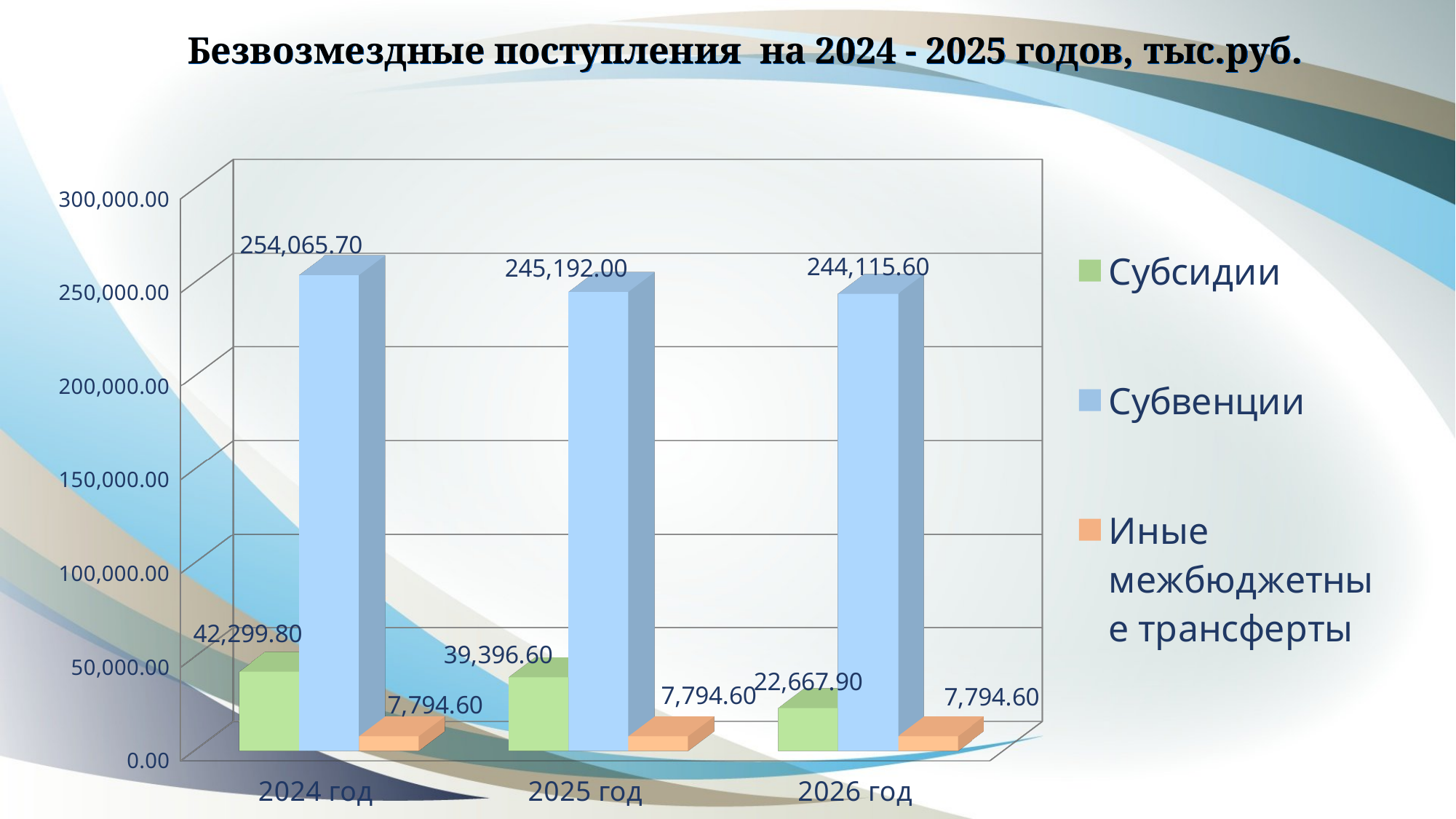
Which is larger: Субвенции in 2025 год or Субвенции in 2026 год? Субвенции in 2025 год Do the values for Субсидии rise or fall from 2024 год to 2026 год? fall How many series does the legend list? 3 What kind of chart is shown on the slide? bar chart Is the value for Субсидии in 2024 год greater or less than 50,000.00? less What is the value for Субвенции in 2024 год? 254,065.70 How many years are shown on the x axis? 3 What is the difference between the Субсидии values for 2024 год and 2025 год? 2,903.20 What is the value for Субсидии in 2026 год? 22,667.90 In which year is the value for Субсидии lowest? 2026 год In which year is the value for Субвенции highest? 2024 год What is the value for Иные межбюджетные трансферты in 2025 год? 7,794.60